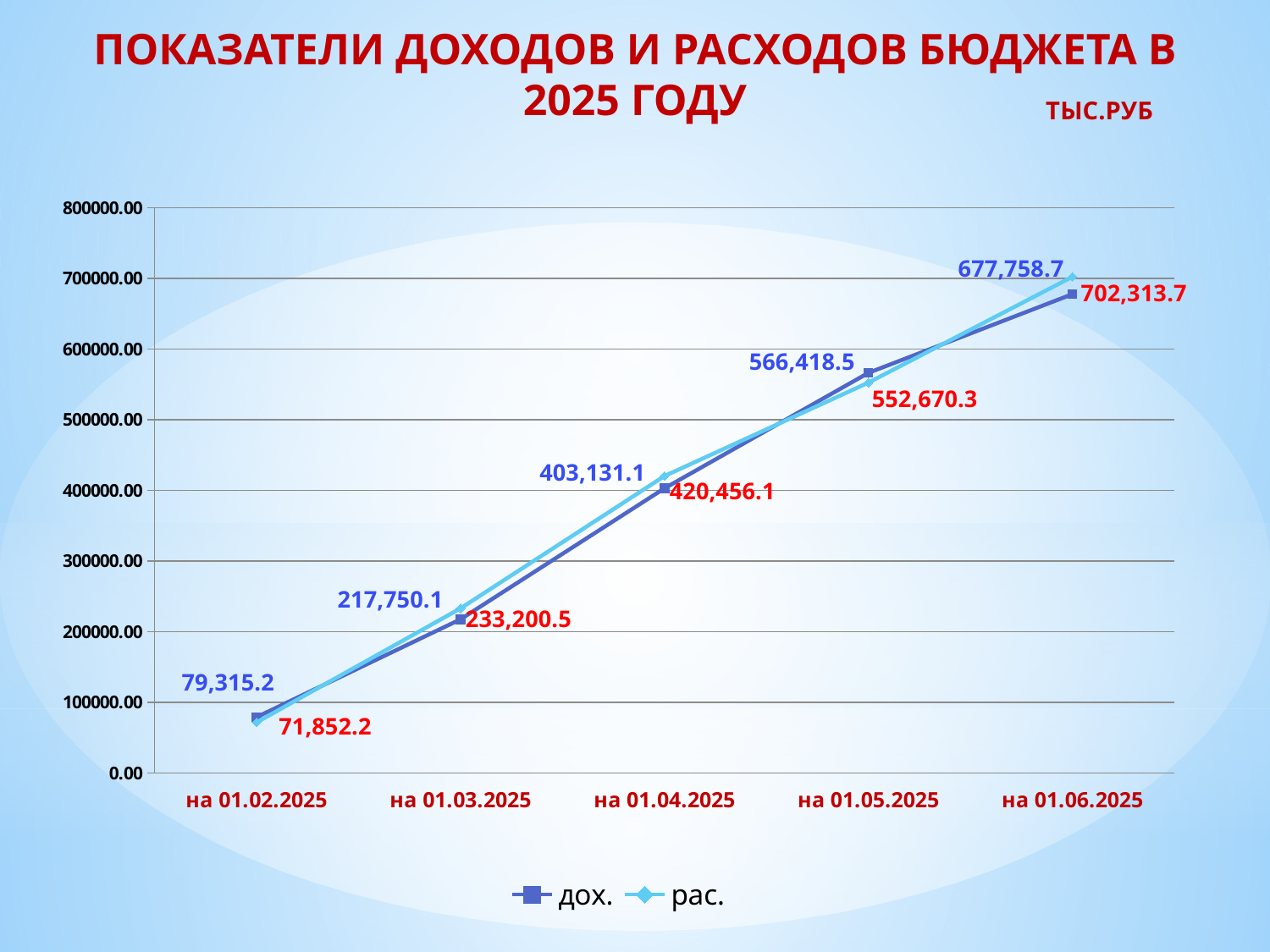
What is the value of дох. на 01.02.2025? 79,315.2 How many dates are shown on the x axis? 5 Do the values of дох. rise or fall from 01.02.2025 to 01.06.2025? rise At which date is the value of дох. highest? на 01.06.2025 What is the value of рас. на 01.05.2025? 552,670.3 How many series does the legend list? 2 At which date is the value of рас. lowest? на 01.02.2025 Which is larger на 01.05.2025, дох. or рас.? дох. What is the difference between рас. and дох. на 01.06.2025? 24,555.0 What is the value of дох. на 01.04.2025? 403,131.1 What is the value of рас. на 01.06.2025? 702,313.7 What type of chart is shown on the slide? line chart